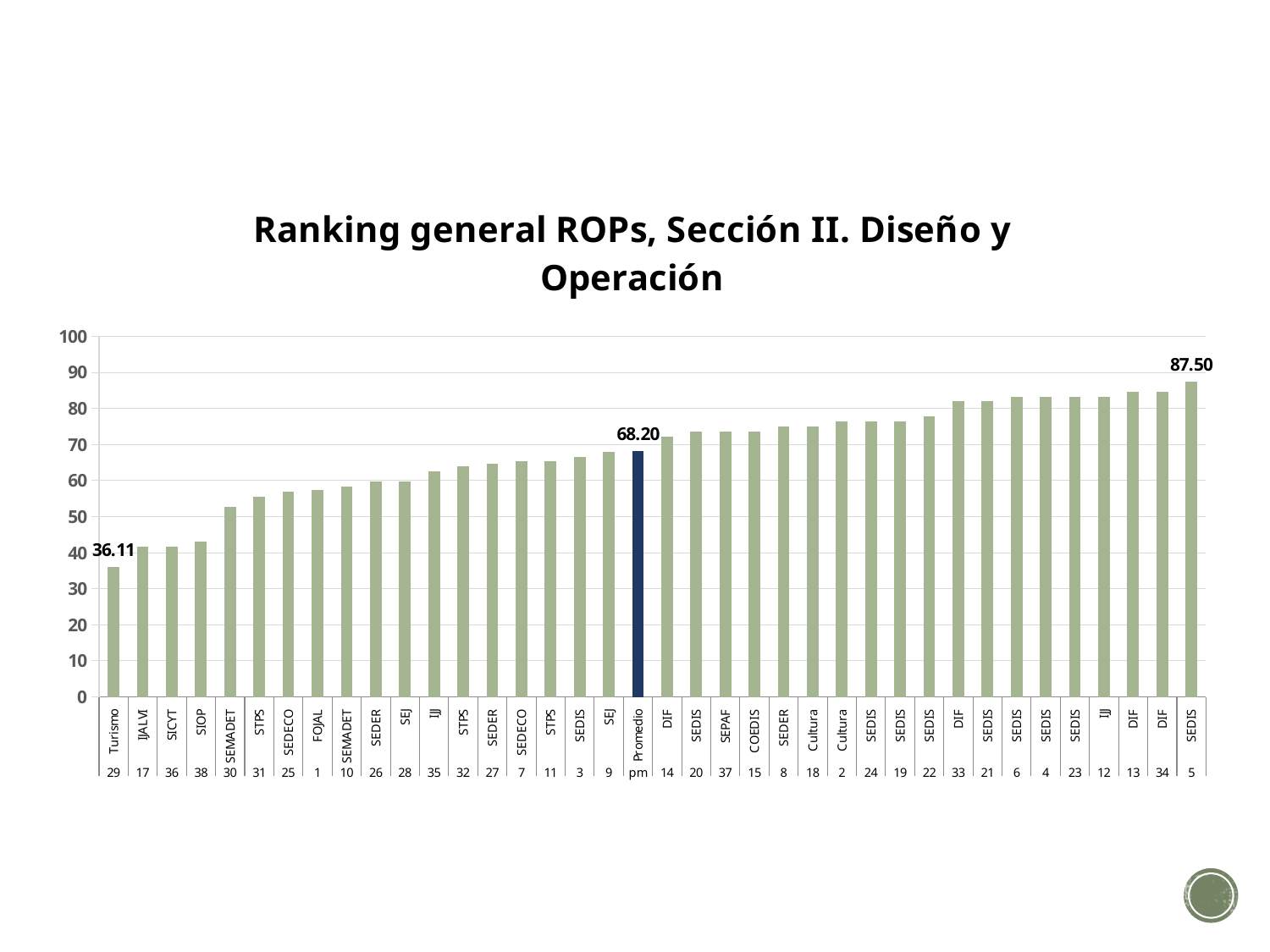
What is the value for SEDIS 5? 87.50 What is the difference between the values for SEDIS 5 and Turismo 29? 51.39 What is the title of the chart? Ranking general ROPs, Sección II. Diseño y Operación What type of chart is shown on the slide? bar chart What is the difference between the values for SEDIS 5 and Promedio? 19.30 Do the values generally rise or fall from left to right along the x axis? rise Which category has the lowest value? Turismo 29 What is the value for Turismo 29? 36.11 Is the value for DIF 33 greater or less than 80? greater Which category has the highest value? SEDIS 5 Is the value for SIOP 38 greater or less than 50? less What is the value for Promedio? 68.20